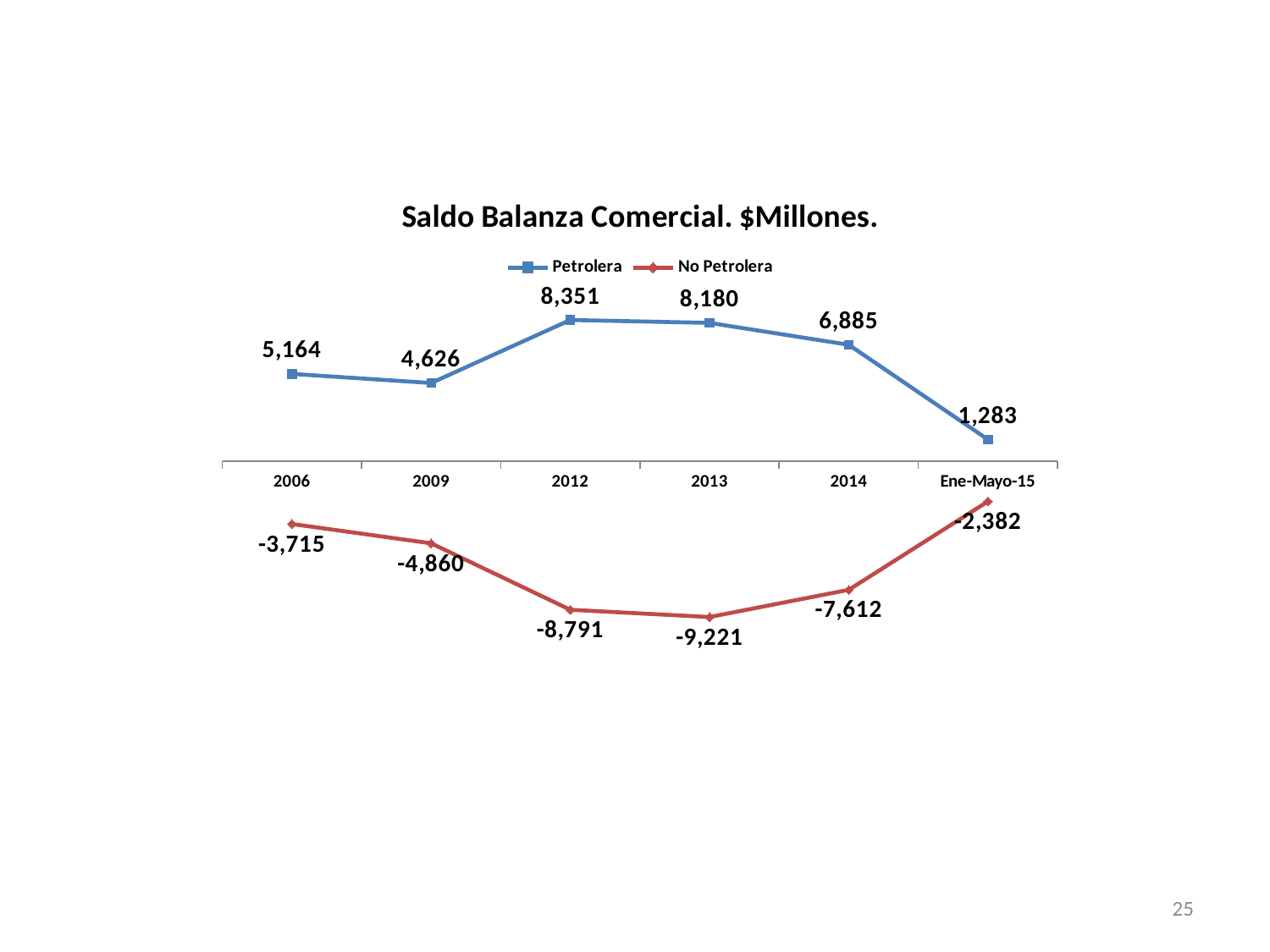
How many series does the legend list? 2 Which is larger, the Petrolera value for 2006 or for 2009? 2006 In which period is the No Petrolera series lowest? 2013 What is the No Petrolera value for 2006? -3,715 In which year is the Petrolera series highest? 2012 What is the title of the chart? Saldo Balanza Comercial. $Millones. What is the Petrolera value for Ene-Mayo-15? 1,283 What kind of chart is this? Line chart What is the Petrolera value for 2012? 8,351 What is the difference between the Petrolera values for 2013 and 2014? 1,295 How many periods are shown on the x axis? 6 What is the No Petrolera value for 2013? -9,221